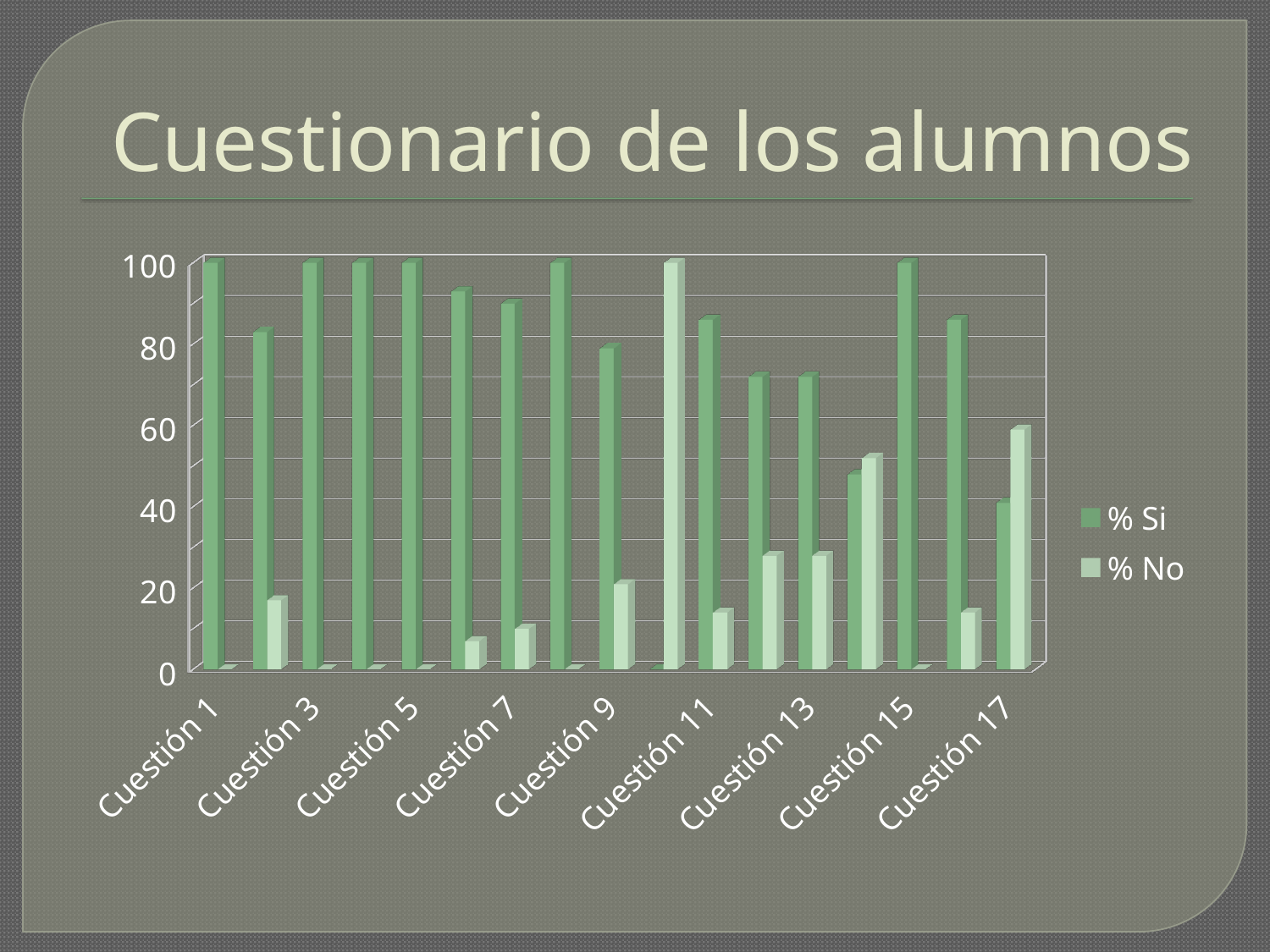
What is the % Si value for Cuestión 1? 100 For Cuestión 13, which is larger: % Si or % No? % Si Is the % No value for Cuestión 13 greater or less than 40? less What is the title of the slide containing the chart? Cuestionario de los alumnos Is the % Si value for Cuestión 11 greater or less than 80? greater What are the two series named in the legend? % Si and % No What kind of chart is shown on the slide? bar chart Is the % Si value for Cuestión 17 greater or less than 60? less For Cuestión 17, which is larger: % Si or % No? % No How many series does the legend list? 2 What is the % Si value for Cuestión 15? 100